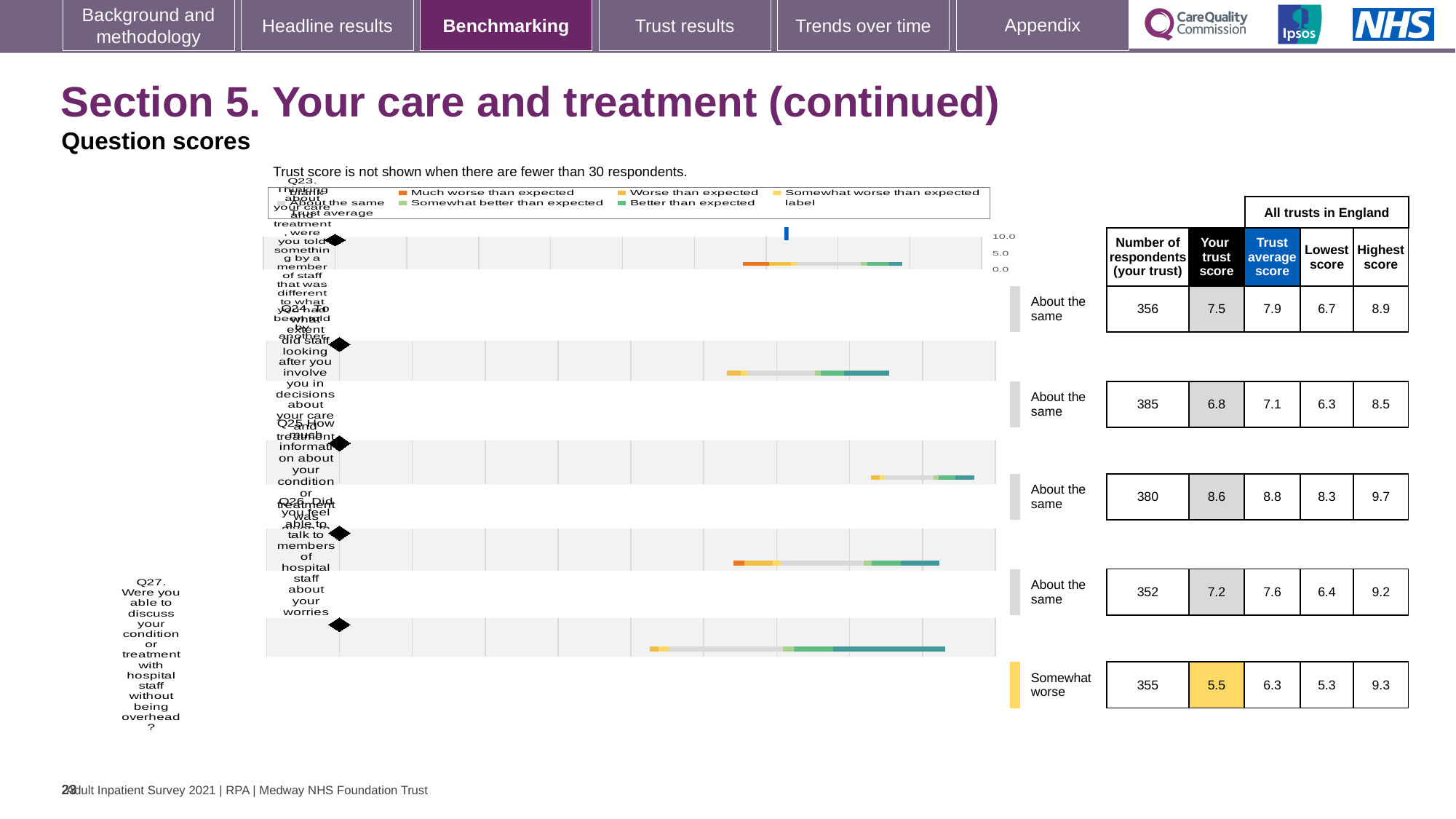
What is the 'Trust average score' for Q25? 8.8 For Q27, what is the difference between the 'Trust average score' and the 'Your trust score'? 0.8 What is the 'Highest score' shown for Q26? 9.2 What is the 'Your trust score' for Q27? 5.5 How many questions are plotted on the chart? 5 Which question has the lowest 'Your trust score'? Q27 Which has the larger 'Your trust score', Q23 or Q26? Q23 Which question has the highest 'Your trust score'? Q25 How many respondents (your trust) are shown for Q24? 385 What is the 'Lowest score' shown for Q23? 6.7 Which question is rated 'Somewhat worse' than expected? Q27 Is the 'Your trust score' for Q25 greater or less than 5.0? greater